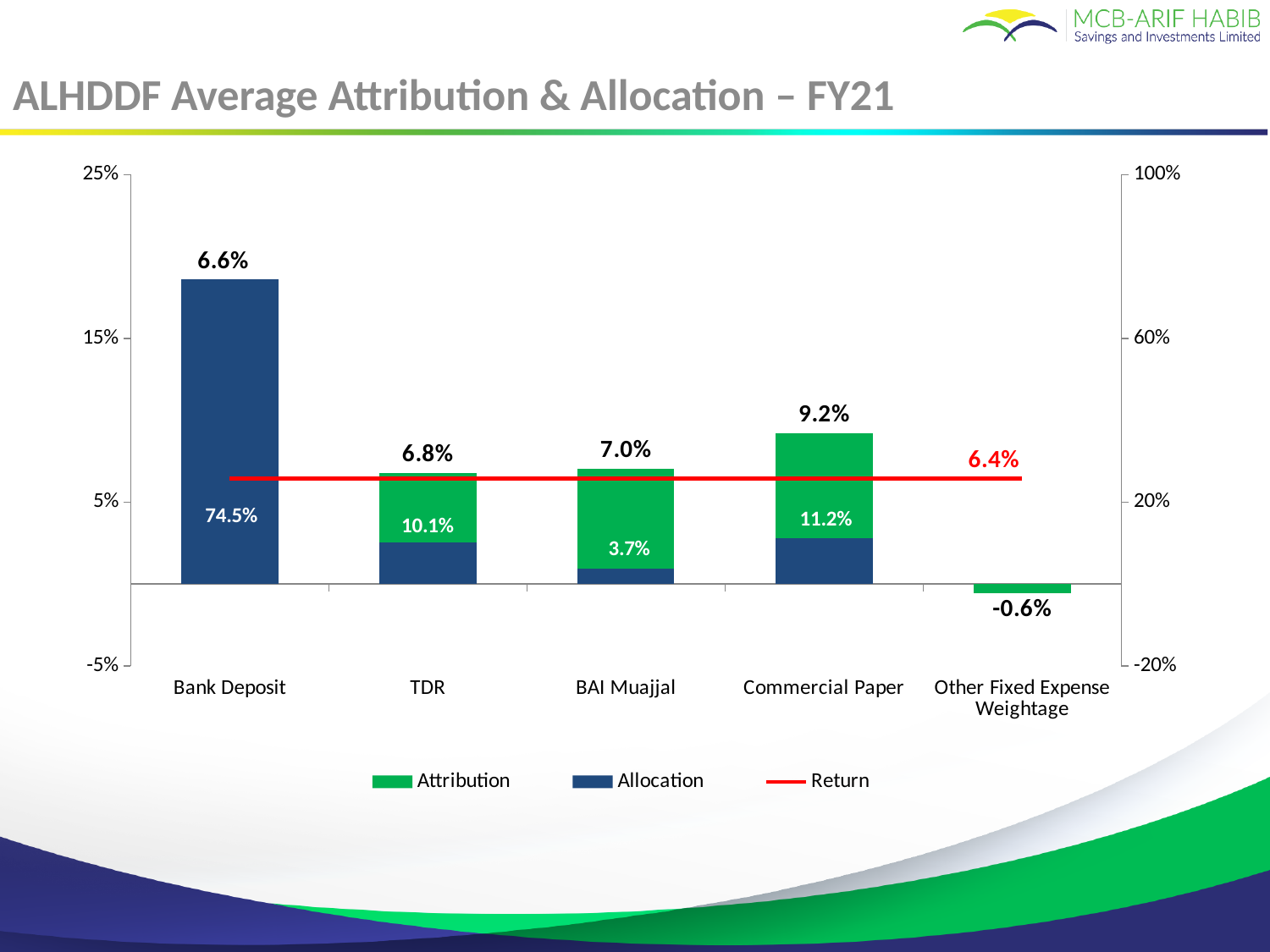
Which category has the lowest Allocation value among those labelled? BAI Muajjal How many categories are shown on the x axis? 5 Which category has the highest Attribution value? Commercial Paper What is the Allocation value for TDR? 10.1% What is the Attribution value for Commercial Paper? 9.2% Which has the larger Allocation value, Commercial Paper or TDR? Commercial Paper How many series does the legend list? 3 What is the Attribution value for Other Fixed Expense Weightage? -0.6% What is the difference between the Attribution values for Commercial Paper and TDR? 2.4 percentage points What is the Attribution value for BAI Muajjal? 7.0% What is the Allocation value for Bank Deposit? 74.5% What value is labelled on the Return line? 6.4%